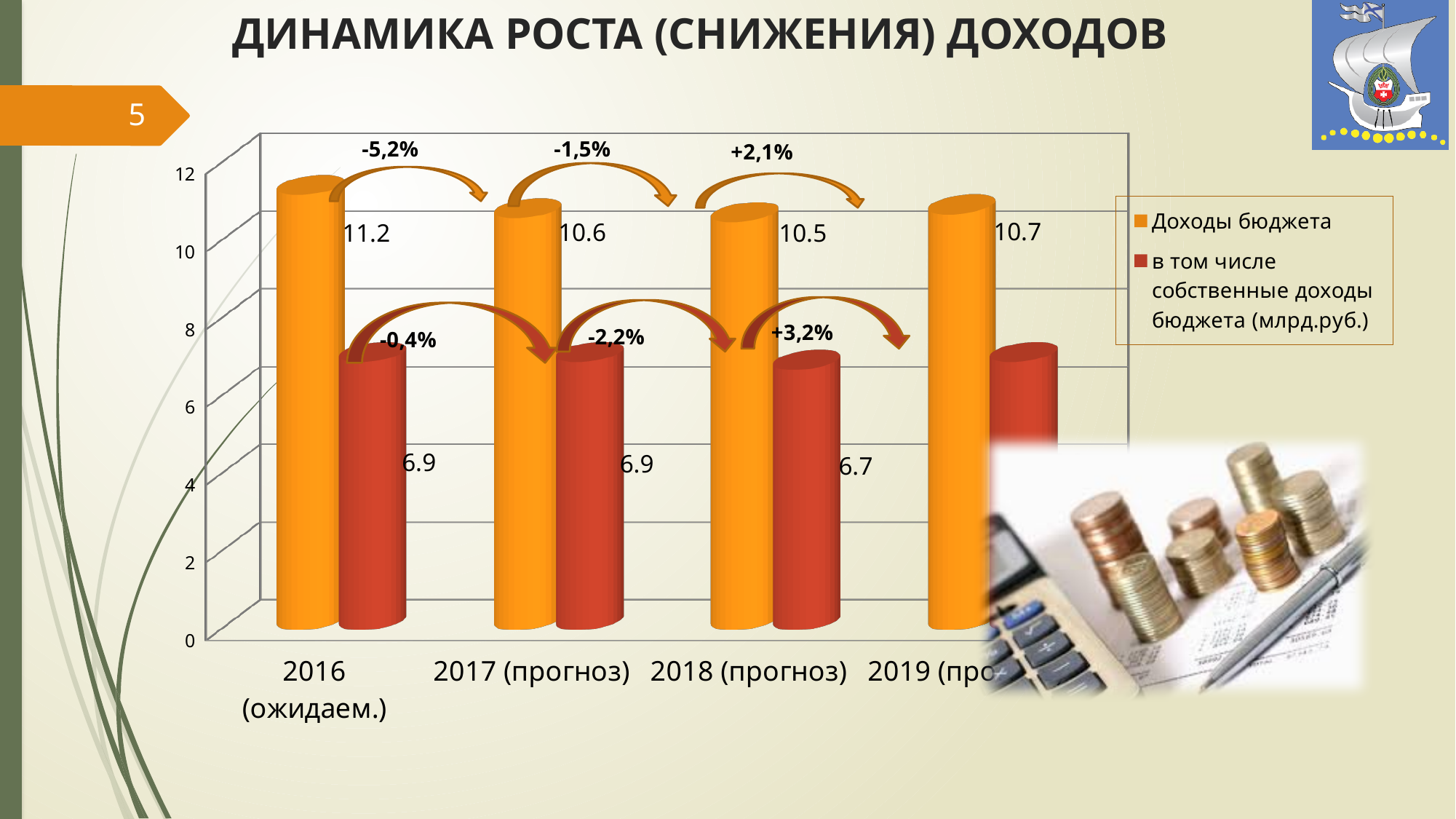
In which year is Доходы бюджета highest? 2016 (ожидаем.) What is the value of Доходы бюджета for 2019 (прогноз)? 10.7 What percentage change is annotated between 2016 and 2017 for Доходы бюджета? -5,2% What is the title of the slide? ДИНАМИКА РОСТА (СНИЖЕНИЯ) ДОХОДОВ In which year is Доходы бюджета lowest? 2018 (прогноз) Is the value of собственные доходы бюджета for 2019 greater or less than 6? greater What is the value of собственные доходы бюджета for 2018 (прогноз)? 6.7 What is the value of Доходы бюджета for 2016 (ожидаем.)? 11.2 What type of chart is shown on the slide? bar chart How many series does the legend list? 2 What is the difference between Доходы бюджета in 2016 and in 2017? 0.6 Which is larger: Доходы бюджета in 2017 (прогноз) or in 2019 (прогноз)? 2019 (прогноз)